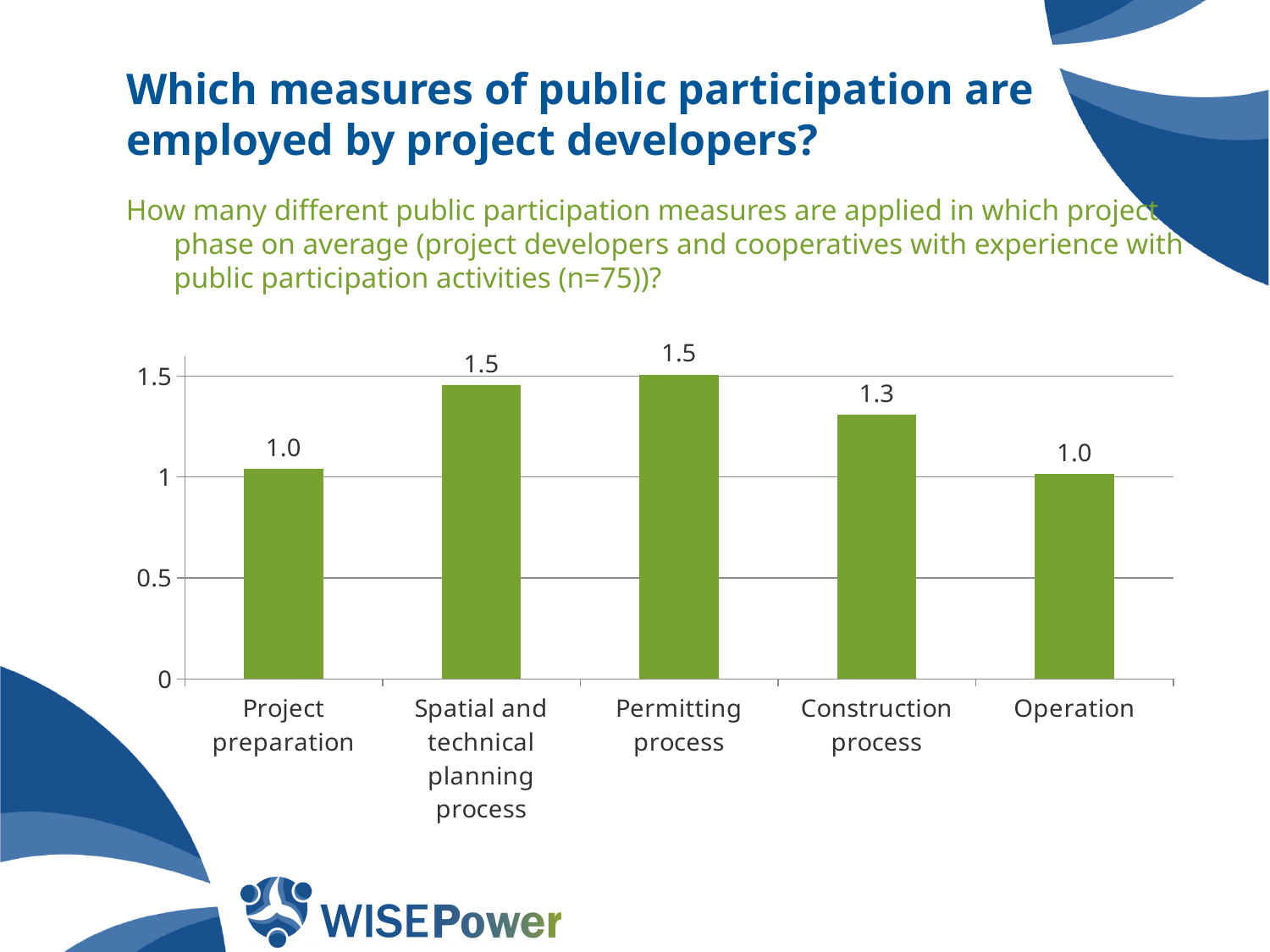
What is the value for Construction process? 1.3 Which is larger, the value for Permitting process or the value for Construction process? Permitting process What is the difference between the values for Permitting process and Construction process? 0.2 What is the difference between the values for Spatial and technical planning process and Project preparation? 0.5 Is the value for Construction process greater or less than 1? greater What is the value for Spatial and technical planning process? 1.5 Which is larger, the value for Construction process or the value for Operation? Construction process What is the value for Permitting process? 1.5 What kind of chart is shown on the slide? bar chart What is the value for Operation? 1.0 How many project phases are shown on the x axis? 5 What is the value for Project preparation? 1.0